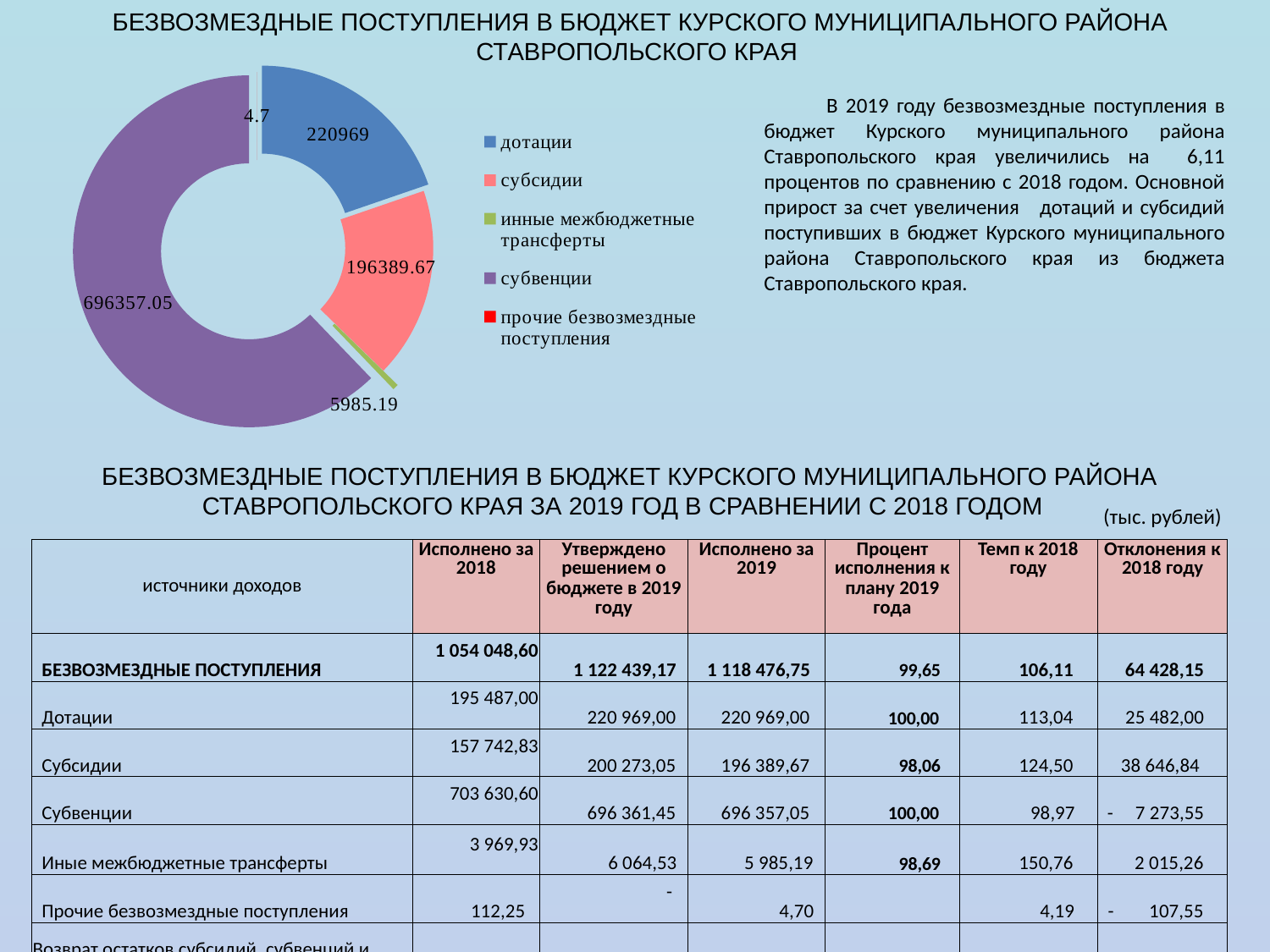
What is the value shown for дотации in the doughnut chart? 220969 How many categories does the legend of the doughnut chart list? 5 Which is larger in the doughnut chart: дотации or субсидии? дотации What is the value shown for инные межбюджетные трансферты in the doughnut chart? 5985.19 What type of chart is shown on the slide? doughnut chart Which category has the smallest value in the doughnut chart? прочие безвозмездные поступления What is the value shown for прочие безвозмездные поступления in the doughnut chart? 4.7 What is the value shown for субсидии in the doughnut chart? 196389.67 What is the value shown for субвенции in the doughnut chart? 696357.05 What colour represents субвенции in the doughnut chart? purple Which category has the largest value in the doughnut chart? субвенции What is the difference between the values for дотации and субсидии in the doughnut chart? 24579.33